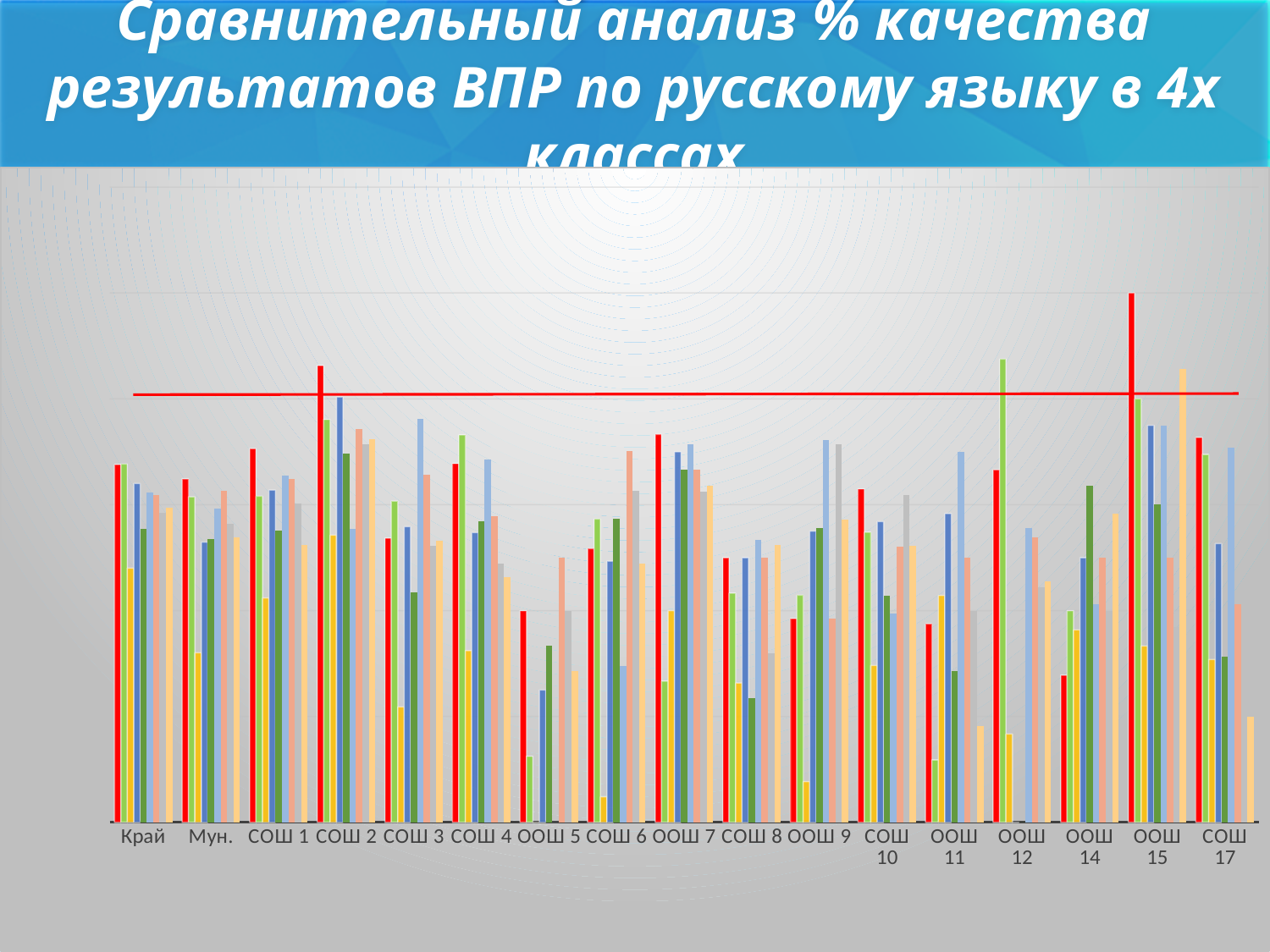
Is the red (first) bar for ООШ 15 taller or shorter than the red (first) bar for Край? taller Is the red (first) bar for СОШ 10 taller or shorter than the red (first) bar for ООШ 7? shorter Which category has the tallest red (first) bar in the chart? ООШ 15 What kind of chart is shown on the slide? bar chart What is the first category on the x axis of the chart? Край How many categories are shown along the x axis of the chart? 17 Is the red (first) bar for СОШ 2 taller or shorter than the red (first) bar for ООШ 5? taller Which category has the shortest red (first) bar in the chart? ООШ 14 What is the title of the slide's chart? Сравнительный анализ % качества результатов ВПР по русскому языку в 4х классах